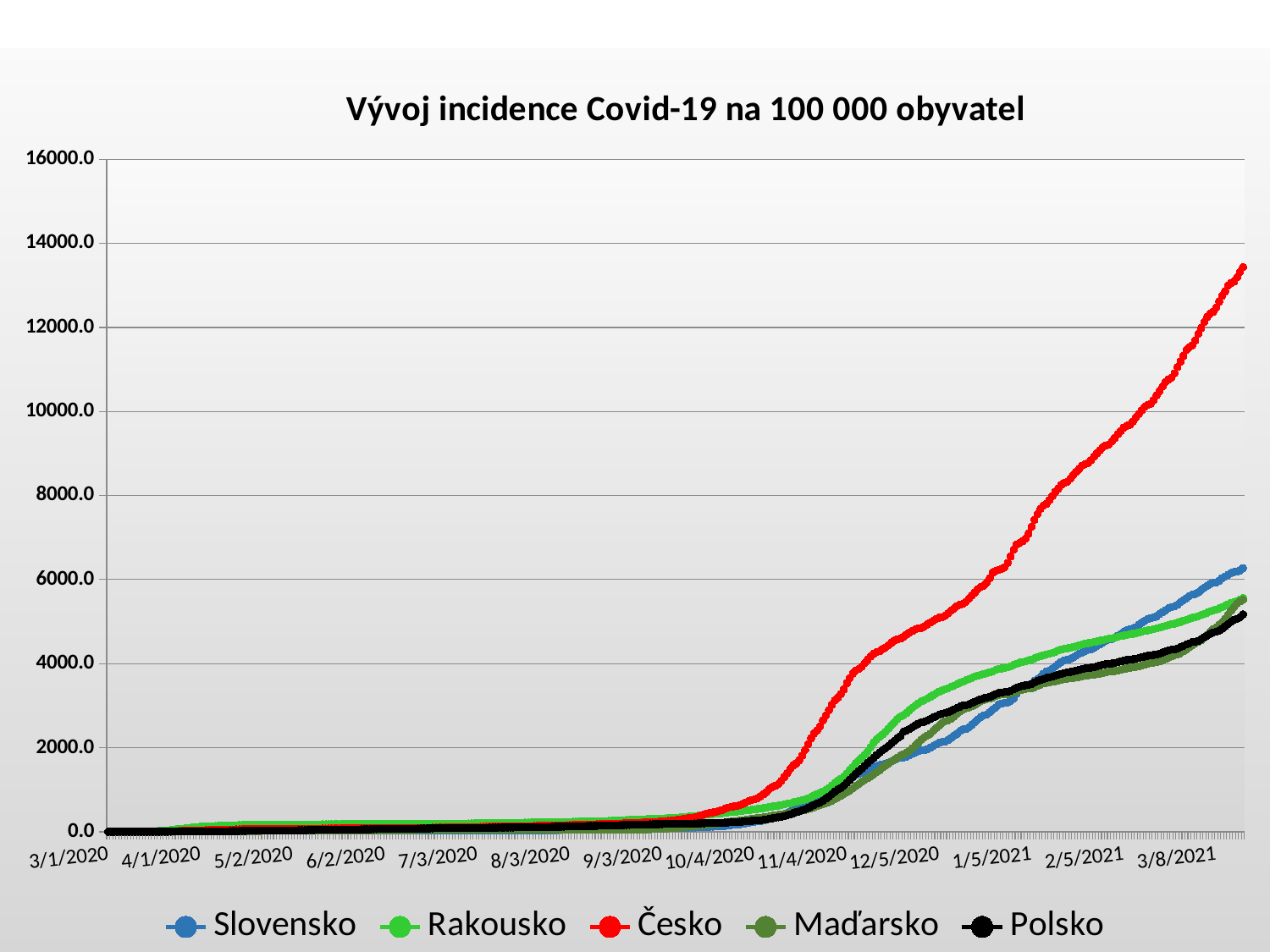
At the right end of the chart, is the value for Česko greater or less than 12000? greater At the right end of the chart, is the value for Polsko greater or less than 6000? less At the right end of the chart, is the value for Slovensko greater or less than 4000? greater How many series does the legend list? 5 What kind of chart is shown on the slide? line chart Which series reaches the highest value at the right end of the chart? Česko Do the values for Česko rise or fall along the x axis from 10/4/2020 to 3/8/2021? rise At the right end of the chart, which is larger: the value for Česko or the value for Slovensko? Česko What is the title of the chart? Vývoj incidence Covid-19 na 100 000 obyvatel Which colour is used for the Česko series? red